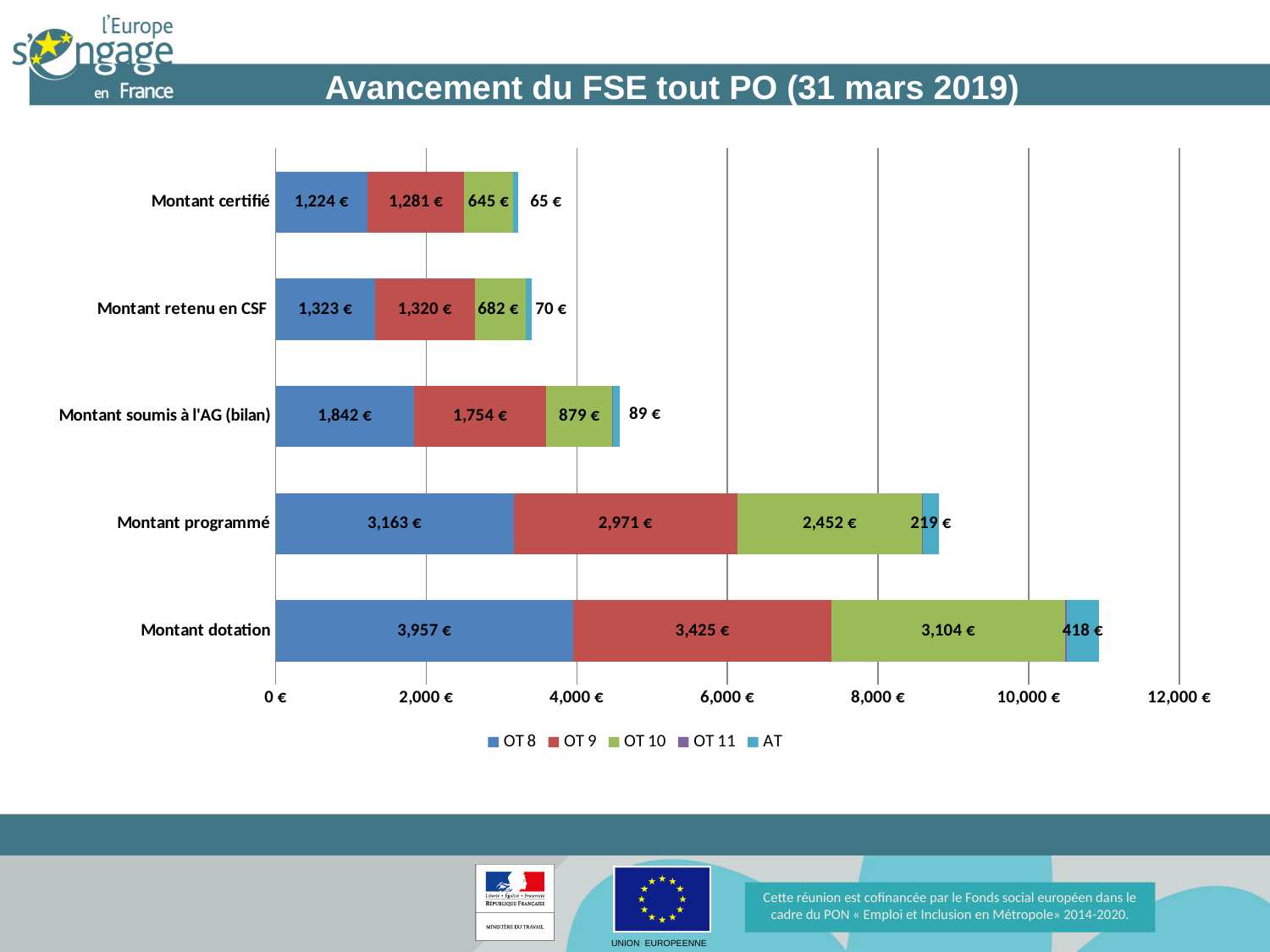
What is the OT 8 value for Montant dotation? 3,957 € Which is larger: the OT 9 value for Montant programmé or the OT 10 value for Montant programmé? OT 9 (2,971 €) What is the AT value for Montant programmé? 219 € What is the OT 10 value for Montant soumis à l'AG (bilan)? 879 € How many categories are shown on the y axis? 5 How many series does the legend list? 5 Which category has the lowest OT 10 value? Montant certifié What kind of chart is shown on the slide? Stacked bar chart Is the total length of the Montant programmé bar greater or less than 8,000 €? greater What is the OT 9 value for Montant retenu en CSF? 1,320 € What is the difference between the OT 8 values for Montant dotation and Montant programmé? 794 € Which category has the highest OT 8 value? Montant dotation